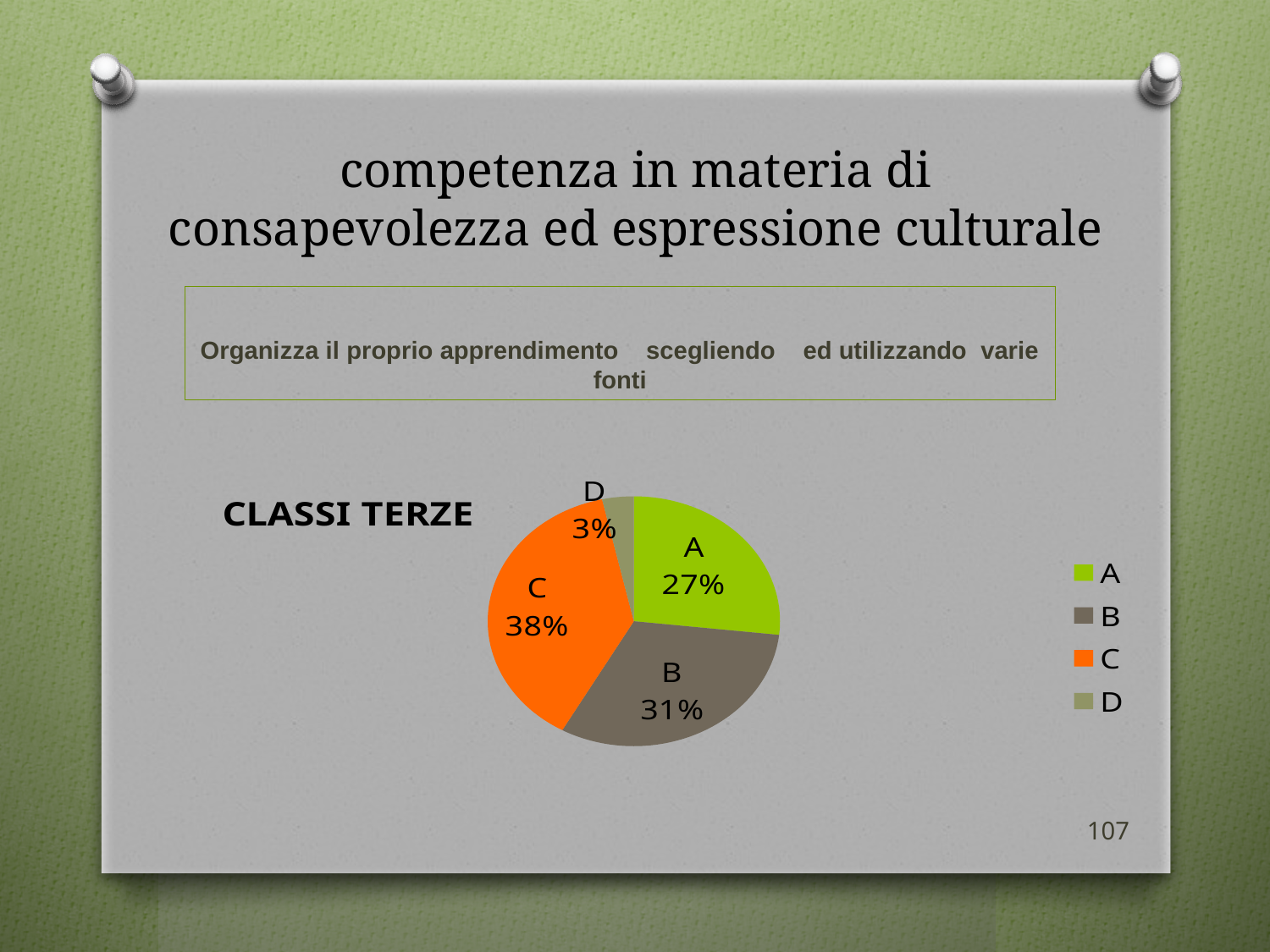
Which slice of the pie chart is the largest? C Which is larger in the pie chart, slice B or slice A? B What percentage does slice C represent in the pie chart? 38% What is the difference in percentage points between slice C and slice A? 11 How many slices does the pie chart have? 4 How many entries does the legend list? 4 What percentage does slice B represent in the pie chart? 31% What kind of chart is shown on the slide? pie chart What colour is slice C in the pie chart? orange What percentage does slice A represent in the pie chart? 27% What percentage does slice D represent in the pie chart? 3% Which slice of the pie chart is the smallest? D